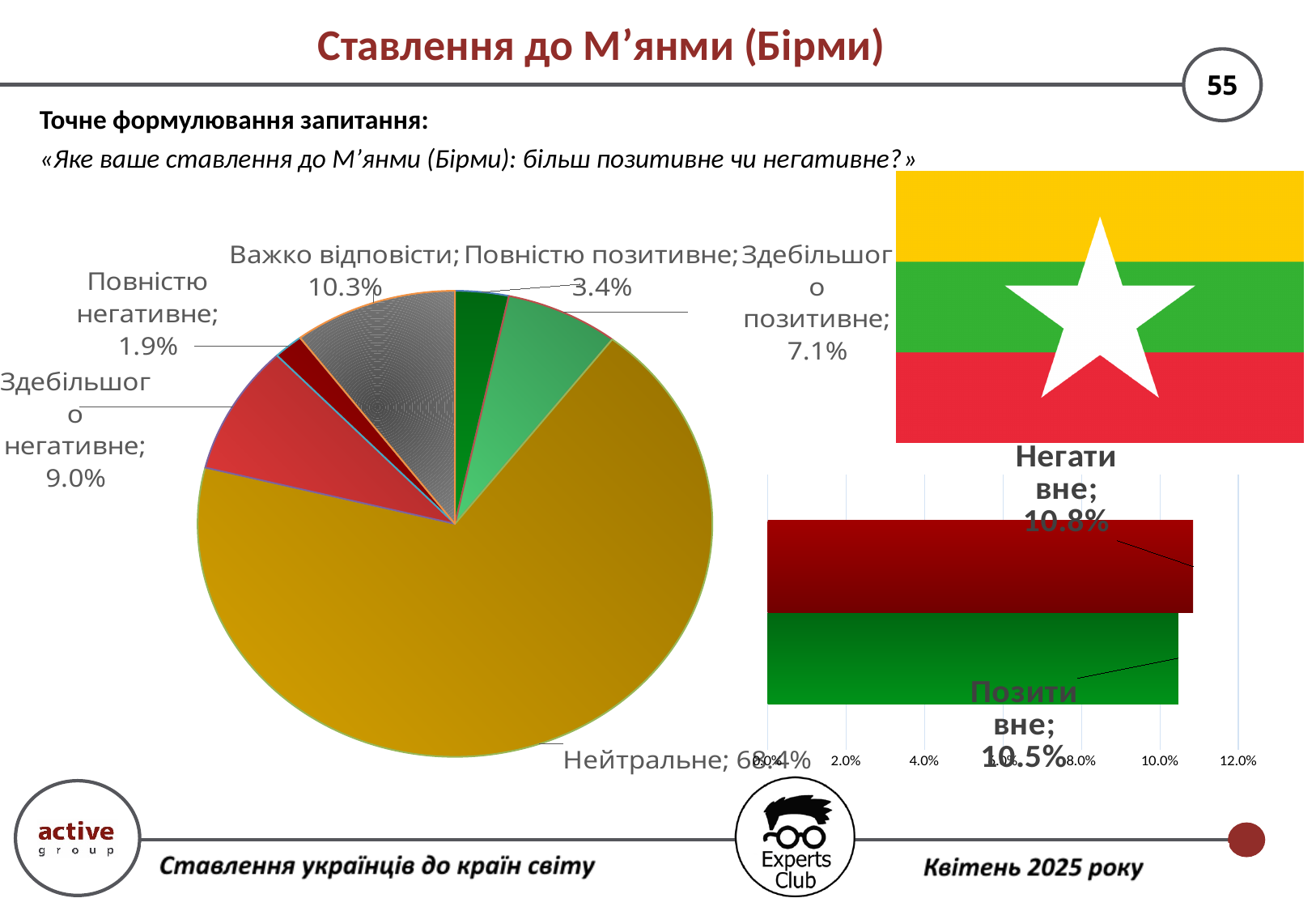
What type of chart is shown at the bottom right of the slide? Bar chart On the pie chart, what share is labelled for «Важко відповісти»? 10.3% On the pie chart, what share is labelled for «Повністю негативне»? 1.9% On the bar chart at the bottom right, what is the difference between «Негативне» and «Позитивне»? 0.3% On the bar chart at the bottom right, what is the value for «Негативне»? 10.8% On the pie chart, which category has the largest slice? Нейтральне On the pie chart, what is the difference between «Здебільшого негативне» and «Здебільшого позитивне»? 1.9% On the pie chart, how many slices are there? 6 On the pie chart, what share is labelled for «Повністю позитивне»? 3.4% On the pie chart, what share is labelled for «Здебільшого негативне»? 9.0% On the bar chart at the bottom right, what is the value for «Позитивне»? 10.5% On the pie chart, which category has the smallest slice? Повністю негативне